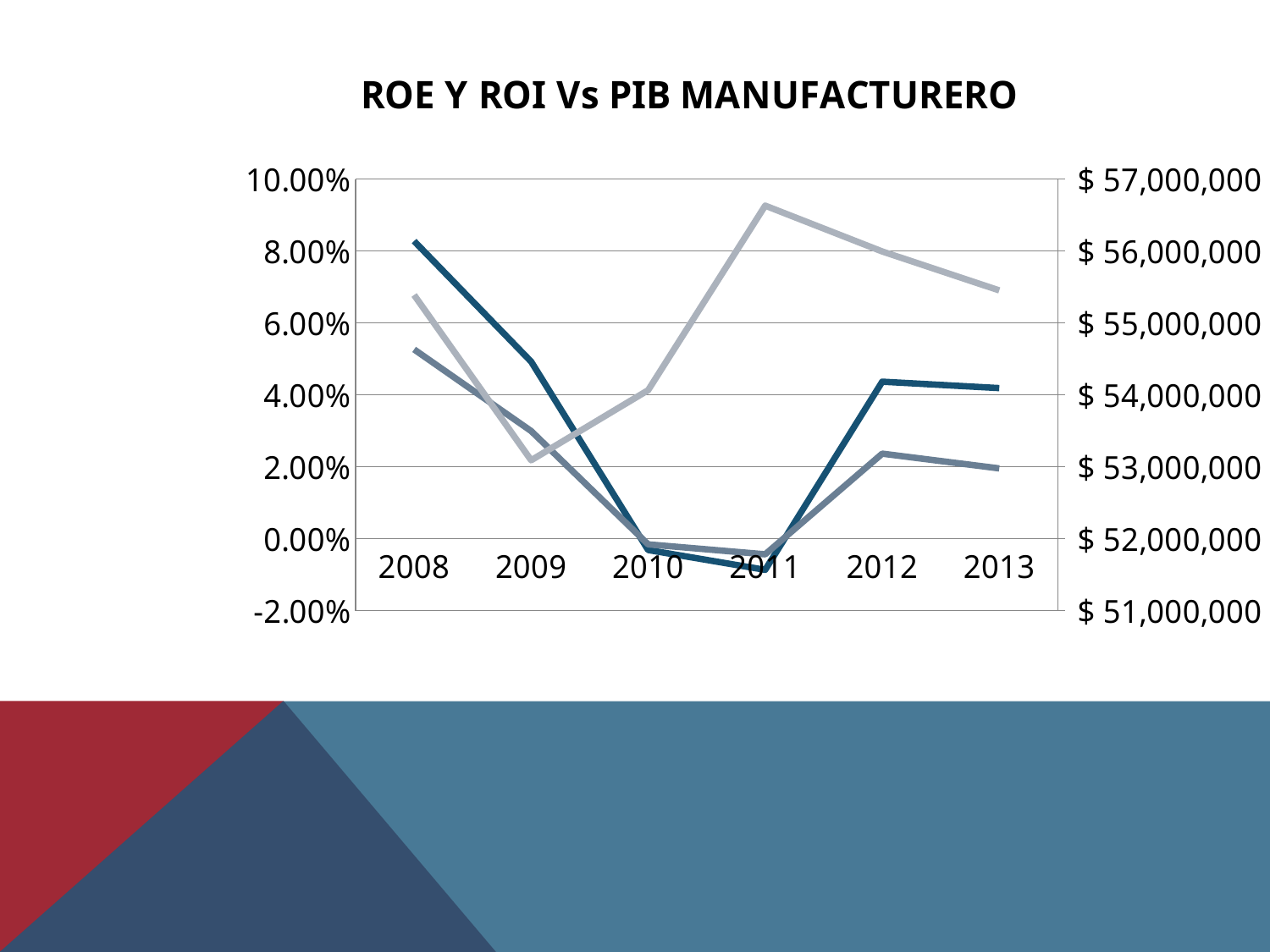
What is the highest value shown on the left vertical axis? 10.00% Is the value of the dark blue line in 2010 greater or less than 0.00% on the left axis? less What kind of chart is shown on the slide? line chart Is the value of the dark blue line in 2008 greater or less than 6.00% on the left axis? greater What is the last year shown on the x axis? 2013 What is the first year shown on the x axis? 2008 How many lines are plotted on the chart? 3 Does the light gray line rise or fall from 2011 to 2013? fall What is the title of the chart? ROE Y ROI Vs PIB MANUFACTURERO How many years are shown along the x axis of the chart? 6 Does the dark blue line rise or fall from 2008 to 2010? fall Does the dark blue line rise or fall from 2011 to 2012? rise